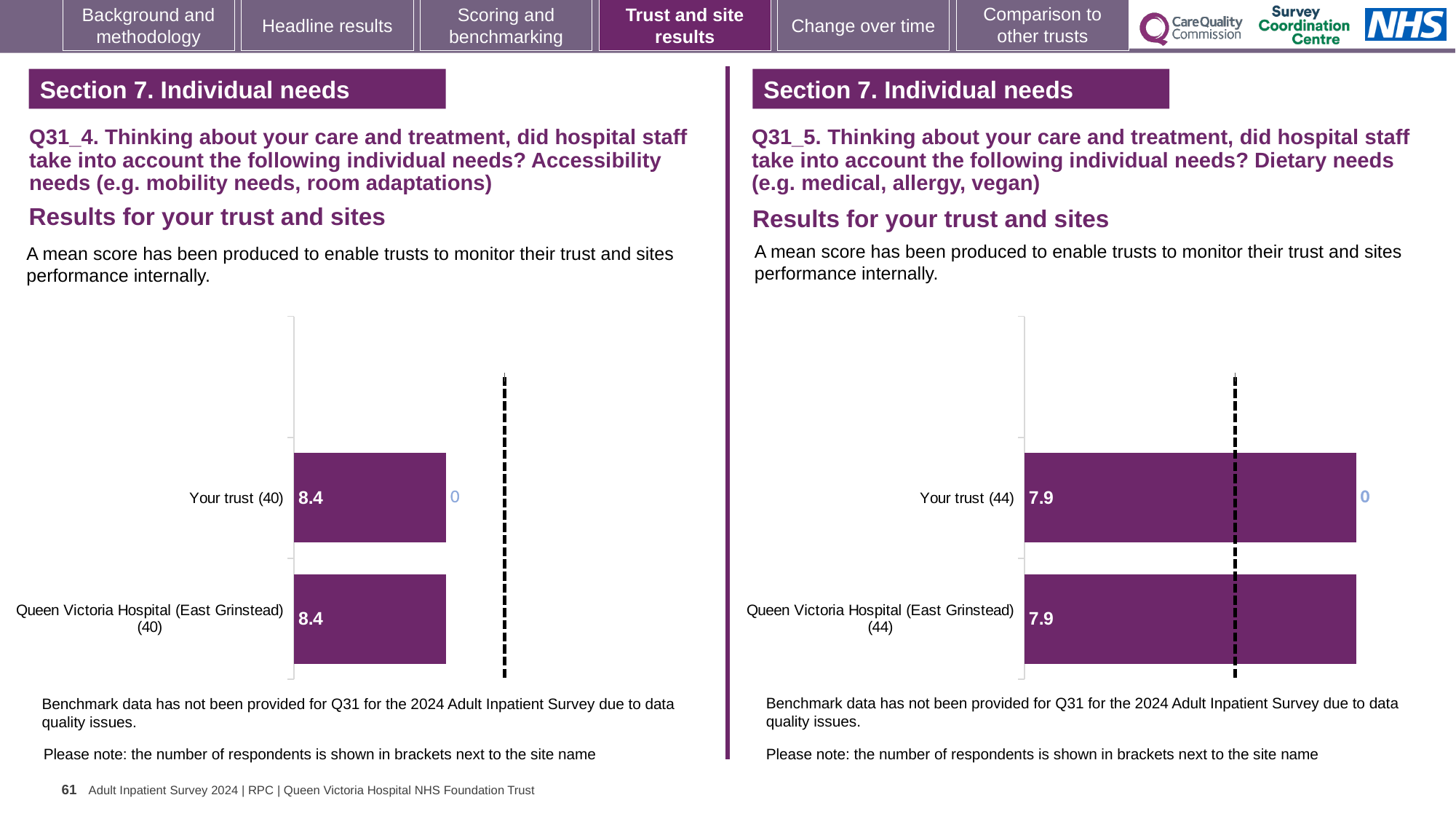
What kind of chart is used on the left (Q31_4, Accessibility needs)? Bar chart Which is larger: the Your trust score on the left chart (Q31_4) or the Your trust score on the right chart (Q31_5)? Left chart (Q31_4), 8.4 On the right chart (Q31_5, Dietary needs), how many respondents are shown in brackets for Queen Victoria Hospital (East Grinstead)? 44 How many bars are plotted on the left chart (Q31_4, Accessibility needs)? 2 On the left chart (Q31_4, Accessibility needs), what is the mean score for Your trust? 8.4 On the right chart (Q31_5, Dietary needs), what is the mean score for Your trust? 7.9 On the left chart (Q31_4, Accessibility needs), what is the mean score for Queen Victoria Hospital (East Grinstead)? 8.4 On the right chart (Q31_5, Dietary needs), what is the mean score for Queen Victoria Hospital (East Grinstead)? 7.9 How many bars are plotted on the right chart (Q31_5, Dietary needs)? 2 On the left chart (Q31_4, Accessibility needs), how many respondents are shown in brackets for Your trust? 40 What is the difference between the Your trust score on the left chart (Q31_4) and the Your trust score on the right chart (Q31_5)? 0.5